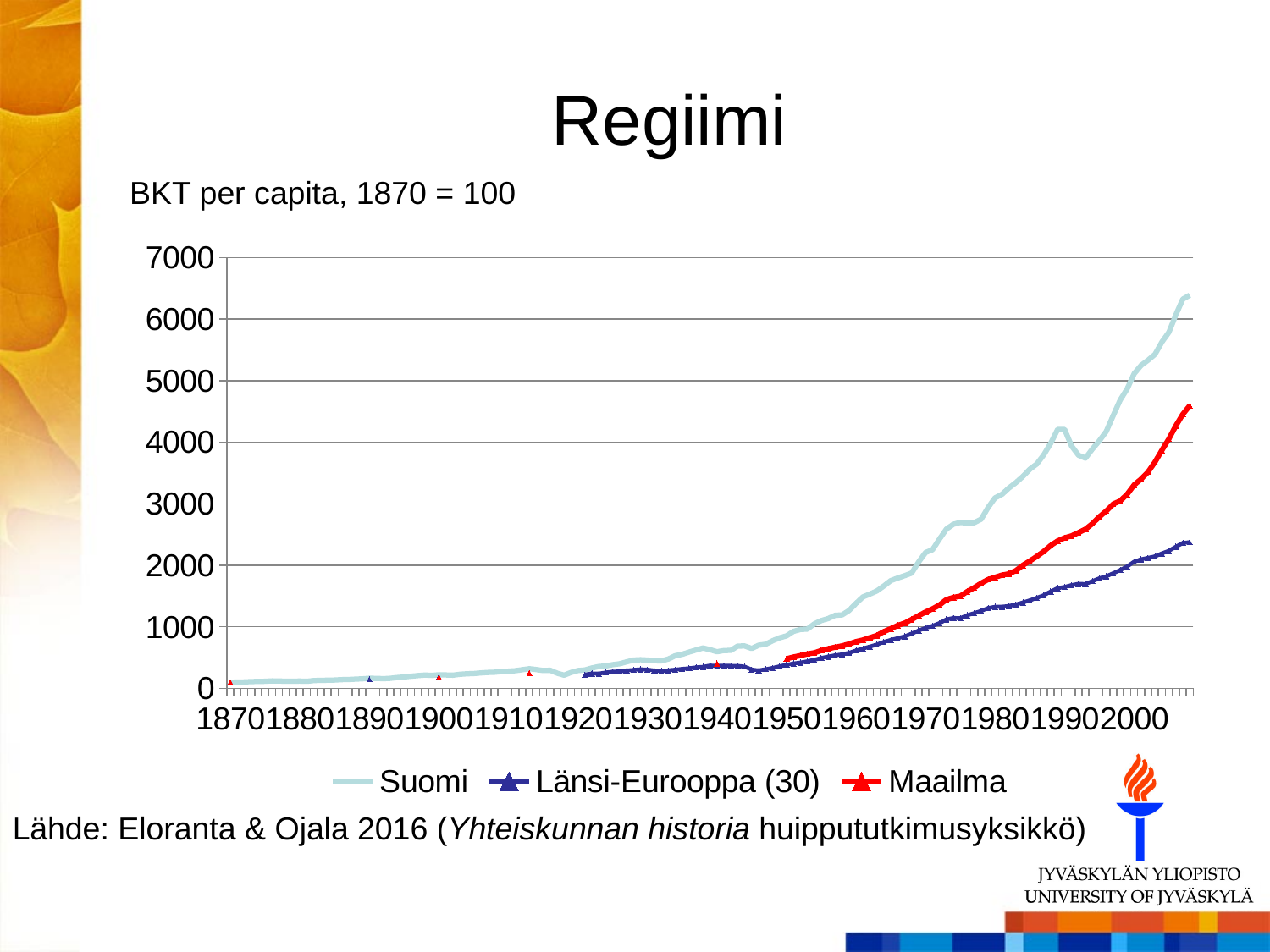
What is the subtitle text shown above the chart describing the measure? BKT per capita, 1870 = 100 Is the value for Maailma in 1990 greater or less than 2000? greater How many series does the legend list? 3 What kind of chart is shown on the slide? line chart At the year 2000, which is larger: Maailma or Länsi-Eurooppa (30)? Maailma What are the three series named in the legend? Suomi, Länsi-Eurooppa (30), Maailma Does the Suomi series generally rise or fall from 1870 to 2000? rise Which series has the lowest value at the year 2000? Länsi-Eurooppa (30) Is the value for Suomi in 2000 greater or less than 6000? less Is the value for Maailma in 2000 greater or less than 5000? less Which series has the highest value at the year 2000? Suomi